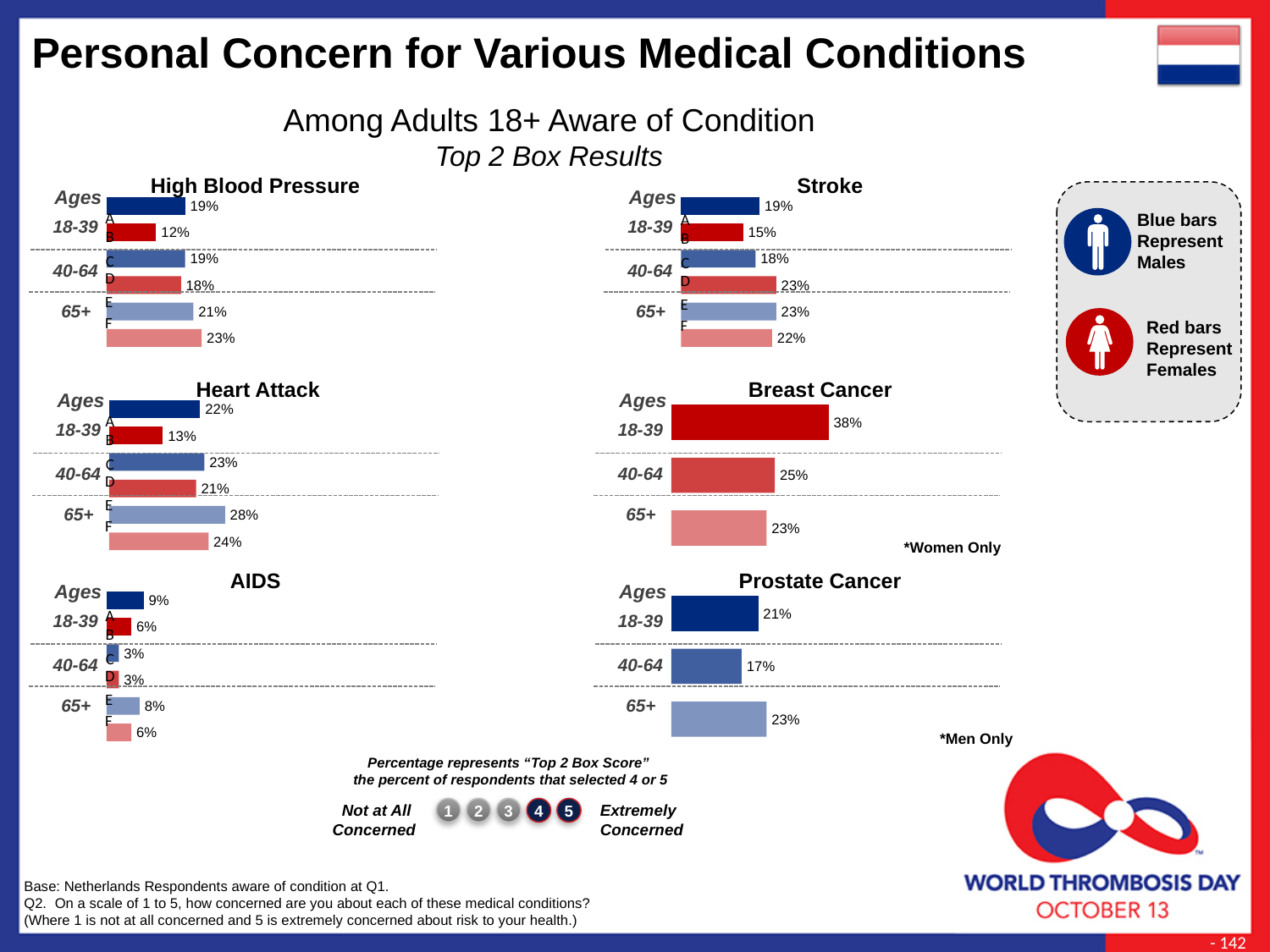
In the Breast Cancer chart, what is the value for women aged 18-39? 38% In the Heart Attack chart, what is the value for males aged 65+? 28% According to the legend on the slide, what do the blue bars represent? Males In the Prostate Cancer chart, which age group has the lowest value? 40-64 How many age groups are shown in the Prostate Cancer chart? 3 In the Heart Attack chart, which is larger for ages 18-39: the male value or the female value? Male value In the Breast Cancer chart, do the values rise or fall from the 18-39 group to the 65+ group? Fall In the Breast Cancer chart, which age group has the highest value? 18-39 In the AIDS chart, what is the value for males aged 40-64? 3% In the Stroke chart, what is the value for females aged 40-64? 23% What type of chart is used for the Stroke data? Bar chart In the High Blood Pressure chart, what is the difference between the male and female values for ages 18-39? 7%